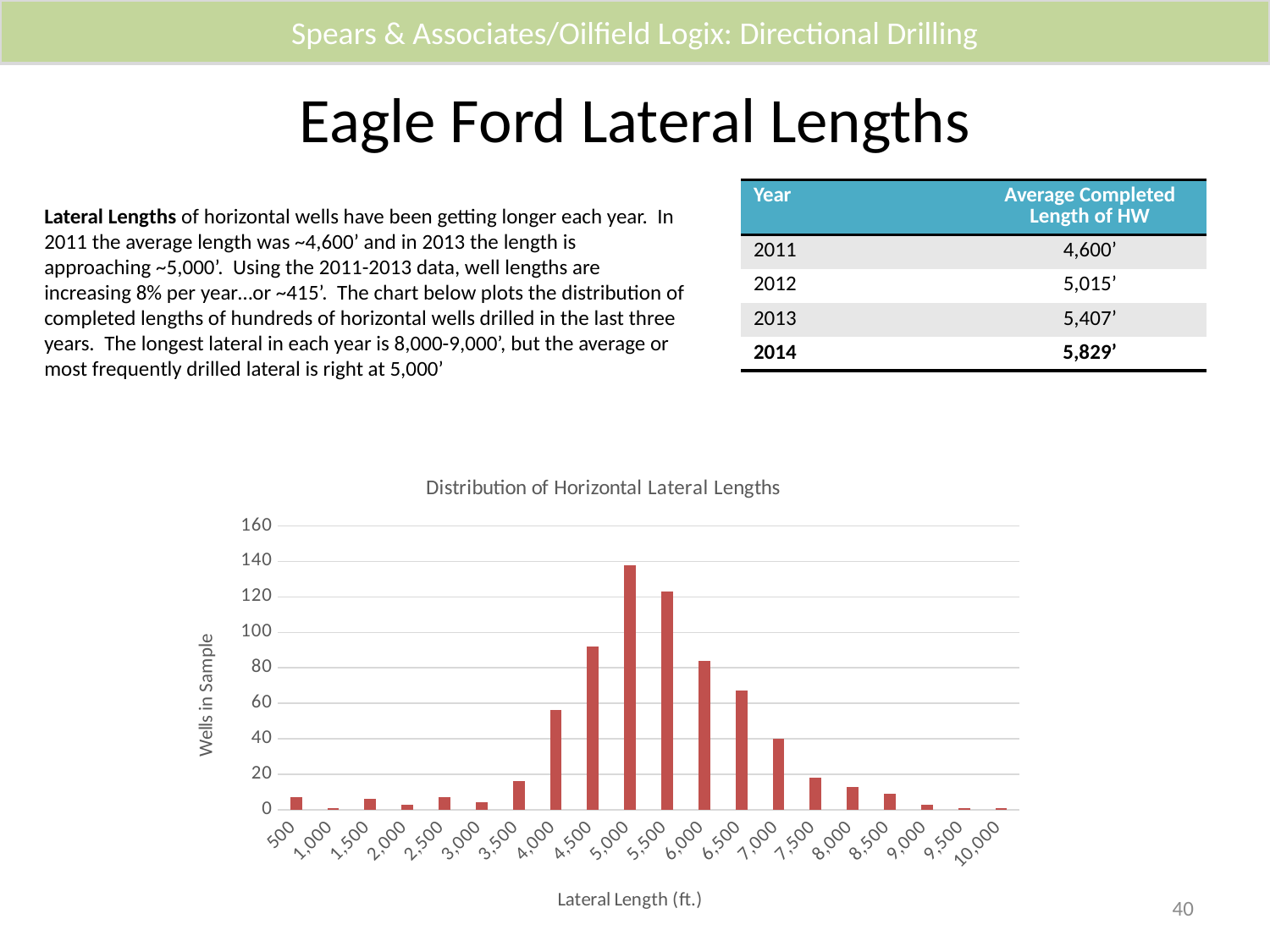
Which has more wells in the sample, 3,500 or 7,500? 7,500 What kind of chart is shown on the slide? bar chart What is the label of the vertical axis of the chart? Wells in Sample Which has more wells in the sample, 4,500 or 6,500? 4,500 What is the title of the chart? Distribution of Horizontal Lateral Lengths Do the values rise or fall along the x axis from 5,000 to 7,500? fall Which lateral length category has the highest number of wells in the sample? 5,000 Is the value for 4,000 greater or less than 60? less Is the value for 7,000 greater or less than 60? less Is the value for 5,000 greater or less than 120? greater How many lateral length categories are shown on the x axis of the chart? 20